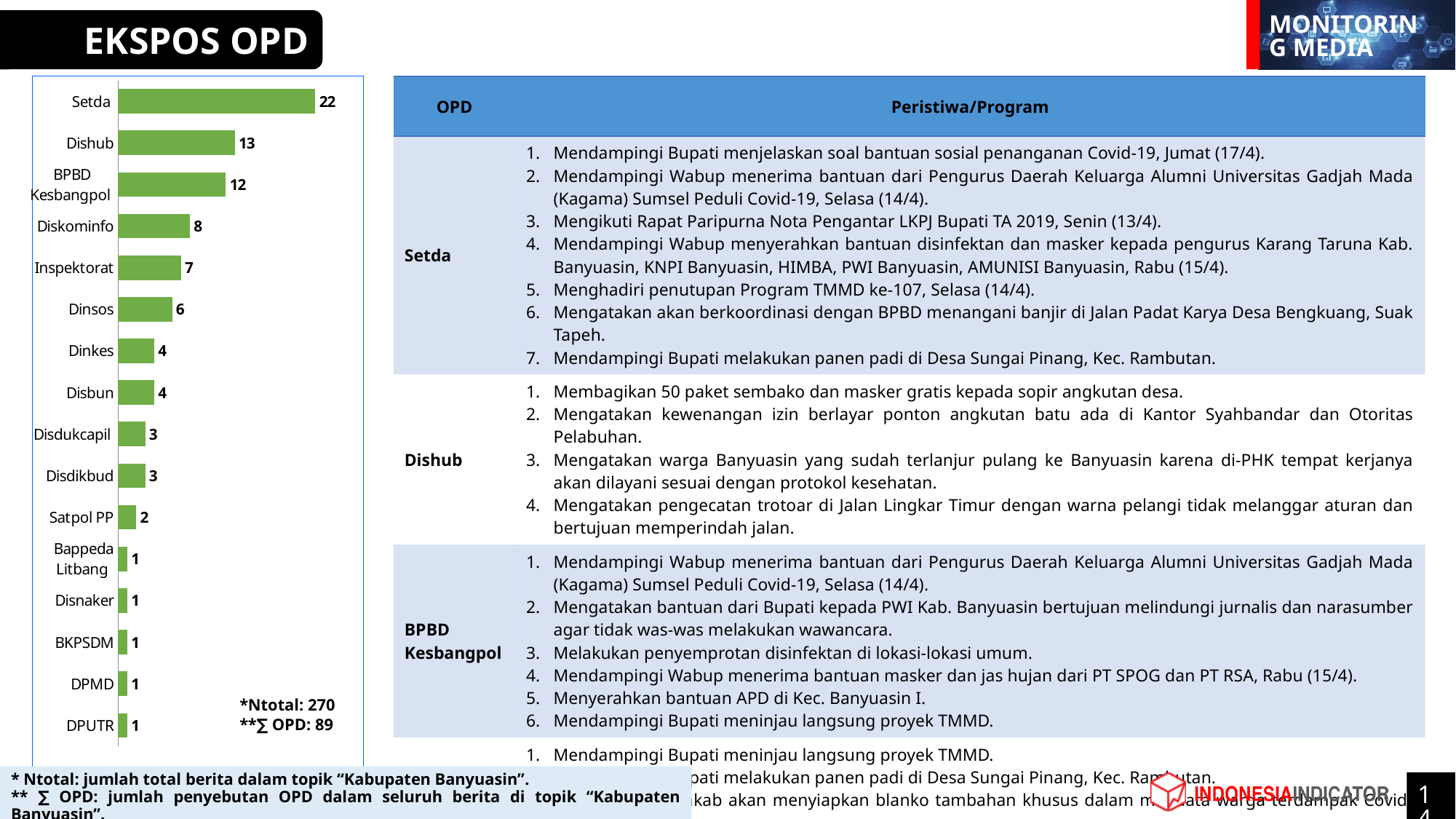
Which OPD has the highest value in the bar chart? Setda What is the value for Dishub in the bar chart? 13 What is the value for Diskominfo in the bar chart? 8 What is the value for Setda in the bar chart? 22 What is the value for Satpol PP in the bar chart? 2 What is the value for BPBD Kesbangpol in the bar chart? 12 What is the difference between the values for Diskominfo and Inspektorat in the bar chart? 1 What kind of chart is shown on the left of the slide? Bar chart What is the Ntotal value noted on the bar chart? 270 How many OPD categories are shown in the bar chart? 16 Which has a larger value in the bar chart, Dinsos or Dinkes? Dinsos What is the difference between the values for Setda and Dishub in the bar chart? 9